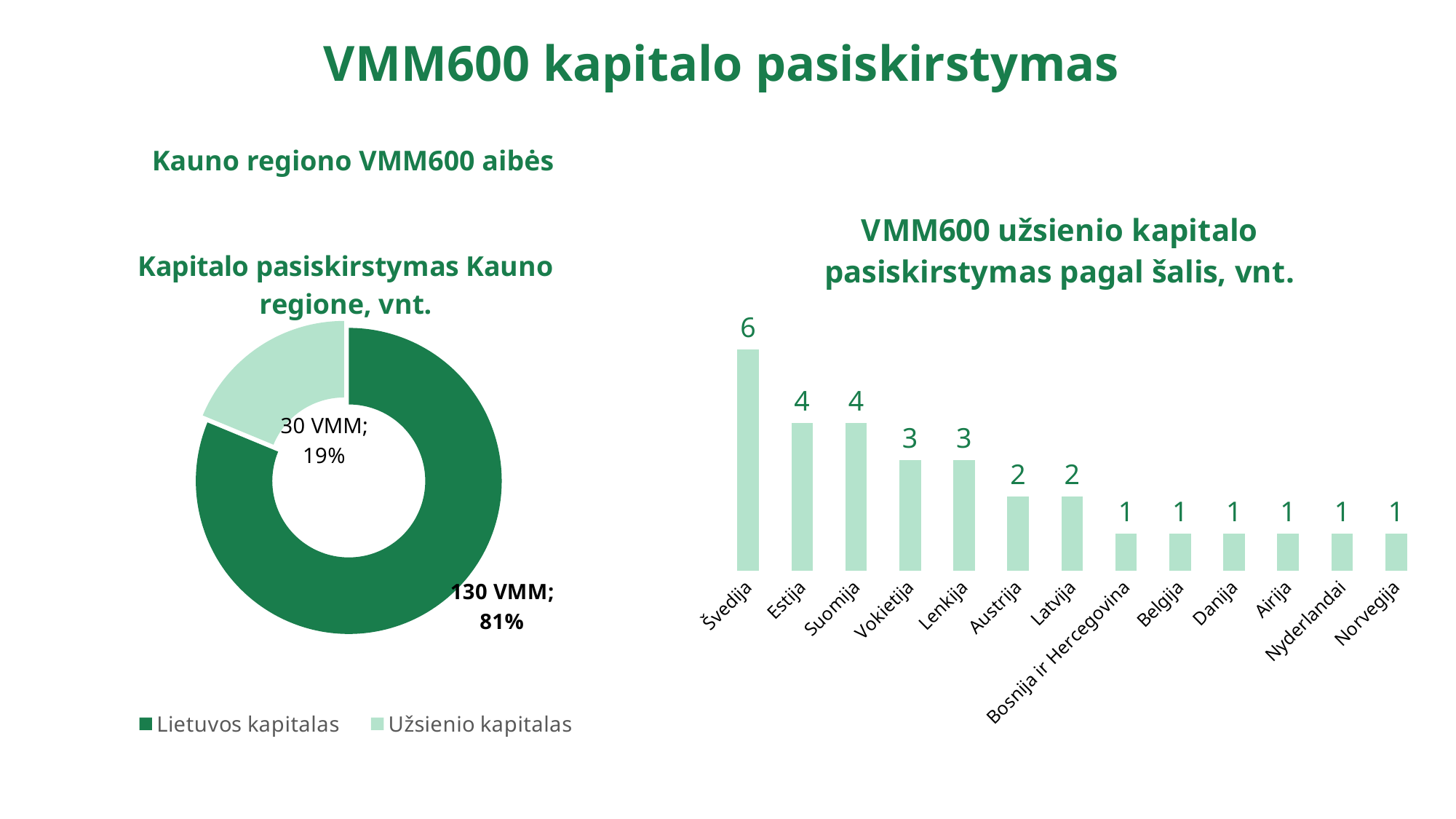
In the chart 'VMM600 užsienio kapitalo pasiskirstymas pagal šalis, vnt.', what is the difference between Švedija and Austrija? 4 In the chart 'VMM600 užsienio kapitalo pasiskirstymas pagal šalis, vnt.', what is the value for Vokietija? 3 In the chart 'VMM600 užsienio kapitalo pasiskirstymas pagal šalis, vnt.', what is the value for Estija? 4 In the chart 'VMM600 užsienio kapitalo pasiskirstymas pagal šalis, vnt.', how many countries are shown? 13 How many entries does the legend of the chart 'Kapitalo pasiskirstymas Kauno regione, vnt.' list? 2 What kind of chart is 'VMM600 užsienio kapitalo pasiskirstymas pagal šalis, vnt.'? Bar chart In the chart 'Kapitalo pasiskirstymas Kauno regione, vnt.', what share of the pie does Lietuvos kapitalas have? 81% In the chart 'Kapitalo pasiskirstymas Kauno regione, vnt.', what is the value for Lietuvos kapitalas? 130 VMM In the chart 'Kapitalo pasiskirstymas Kauno regione, vnt.', what is the difference between Lietuvos kapitalas and Užsienio kapitalas? 100 VMM In the chart 'Kapitalo pasiskirstymas Kauno regione, vnt.', what share of the pie does Užsienio kapitalas have? 19% What kind of chart is 'Kapitalo pasiskirstymas Kauno regione, vnt.'? Pie (doughnut) chart In the chart 'VMM600 užsienio kapitalo pasiskirstymas pagal šalis, vnt.', which country has the highest value? Švedija